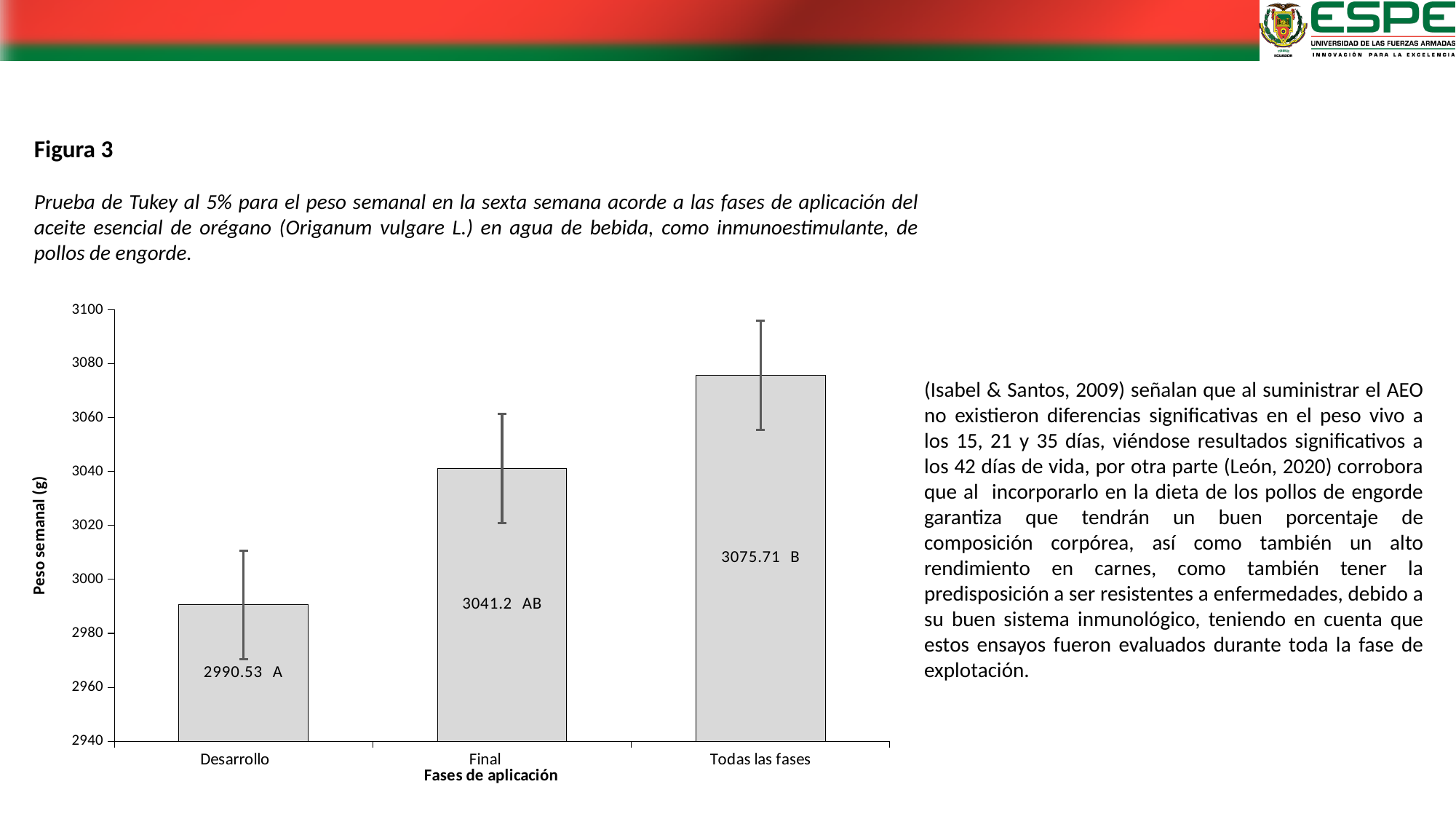
What is the weekly weight value shown for the Desarrollo phase? 2990.53 Which has a larger weekly weight, Final or Desarrollo? Final Is the value for Todas las fases greater or less than 3060? greater What is the difference in weekly weight between Todas las fases and Desarrollo? 85.18 Which application phase has the lowest weekly weight? Desarrollo How many application phases are shown on the x axis? 3 What is the weekly weight value shown for the Final phase? 3041.2 What is the label of the y axis of the chart? Peso semanal (g) Which application phase has the highest weekly weight? Todas las fases What is the difference in weekly weight between Final and Desarrollo? 50.67 What is the weekly weight value shown for Todas las fases? 3075.71 What type of chart is shown on the slide? Bar chart